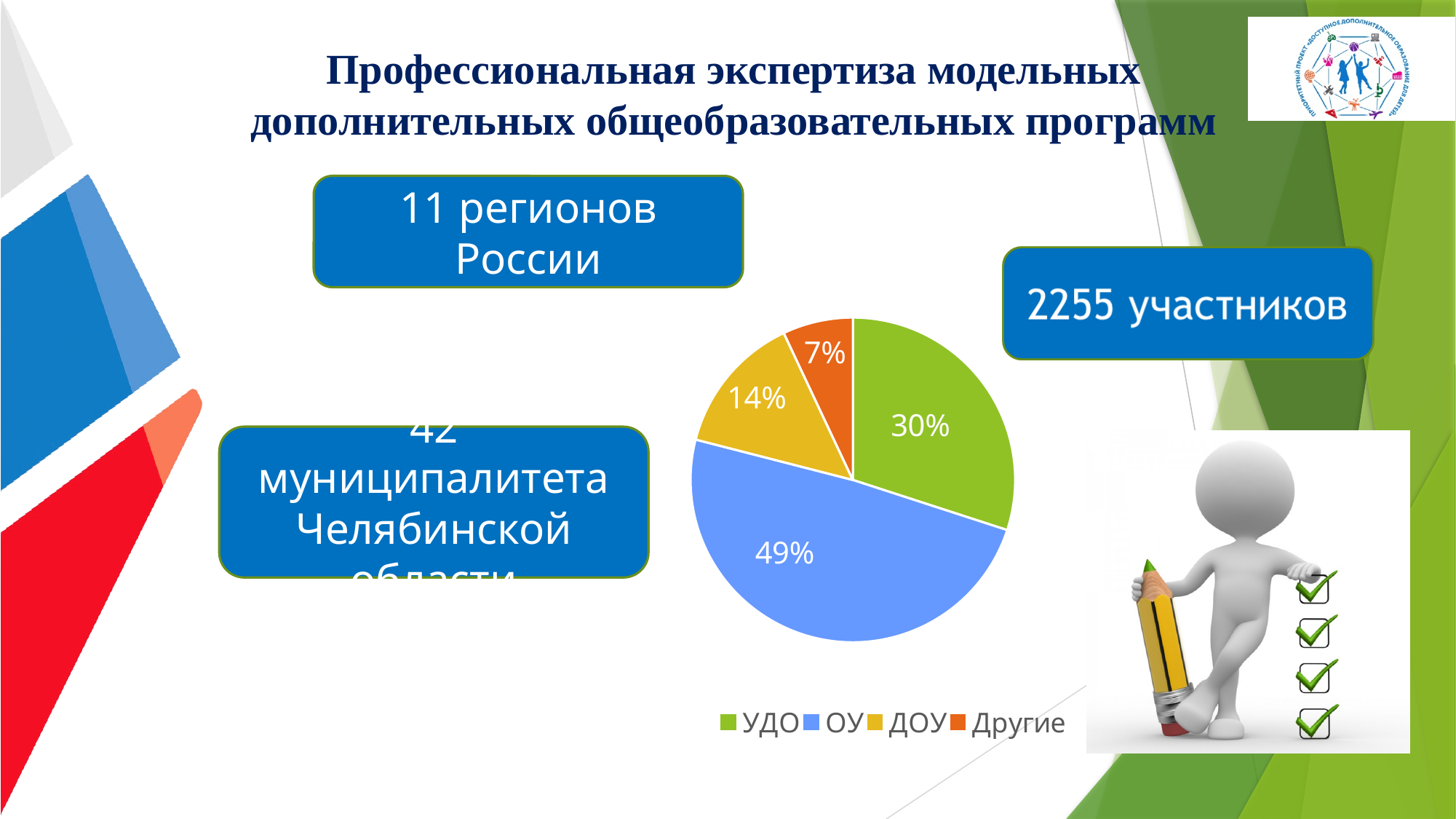
What share of the pie does ОУ have? 49% What is the combined share of the ДОУ and Другие slices? 21% What kind of chart is shown on the slide? pie chart What share of the pie does ДОУ have? 14% Which colour represents ОУ in the legend? blue Which slice is larger, ДОУ or Другие? ДОУ What share of the pie does УДО have? 30% What is the difference in percentage points between the ОУ and УДО slices? 19% How many categories does the pie chart show? 4 Which category has the smallest slice of the pie? Другие What share of the pie does Другие have? 7% Which category has the largest slice of the pie? ОУ